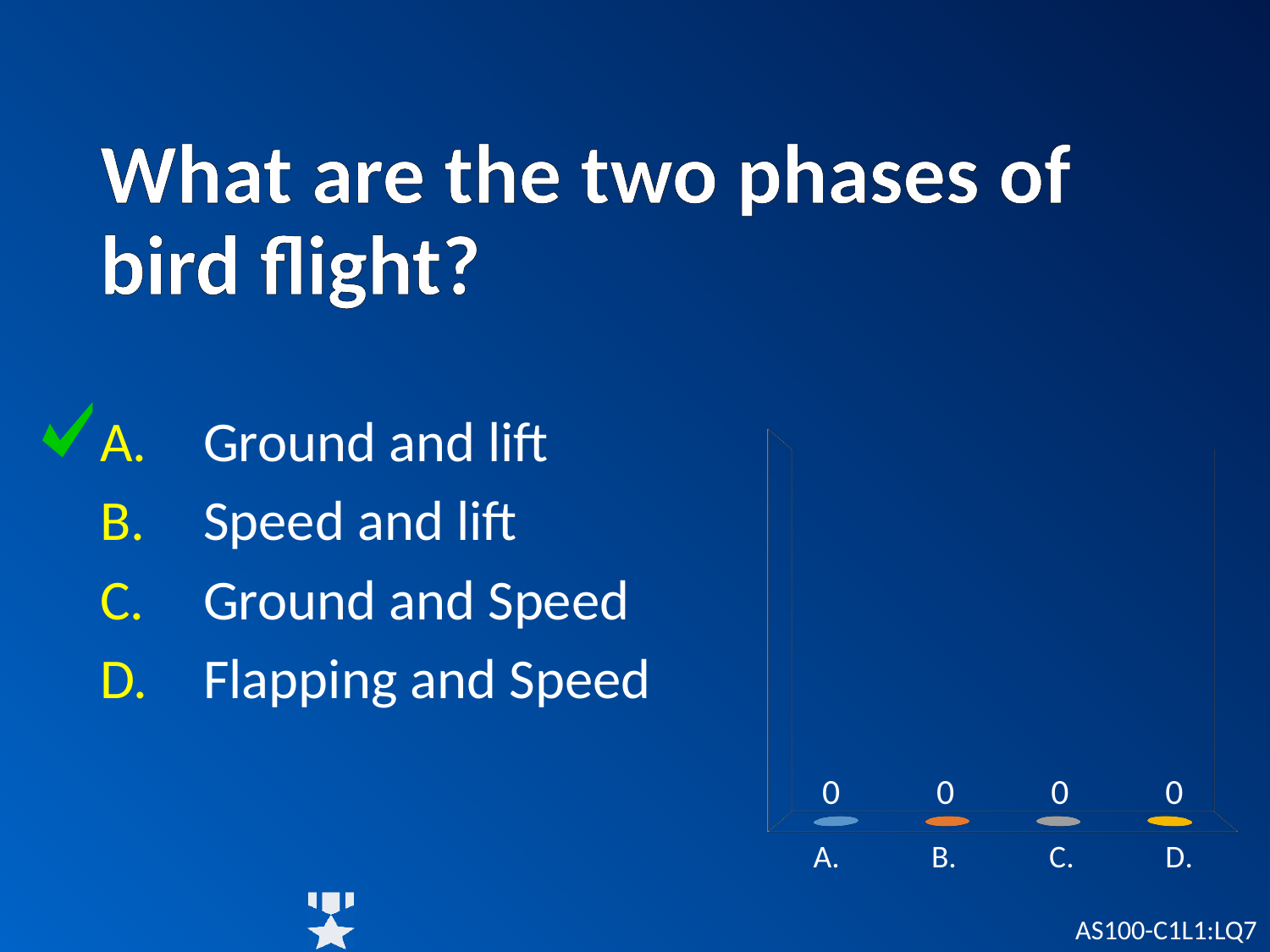
What is the value for category A. in the chart? 0 What is the difference between the values for A. and D. in the chart? 0 What are the category labels on the x axis of the chart, in order? A., B., C., D. How many categories are shown on the x axis of the chart? 4 What is the value for category B. in the chart? 0 What colour is the bar for category B. in the chart? orange What is the value for category C. in the chart? 0 What kind of chart is shown on the slide? bar chart What is the value for category D. in the chart? 0 Do the values rise, fall, or stay flat from A. to D. in the chart? flat